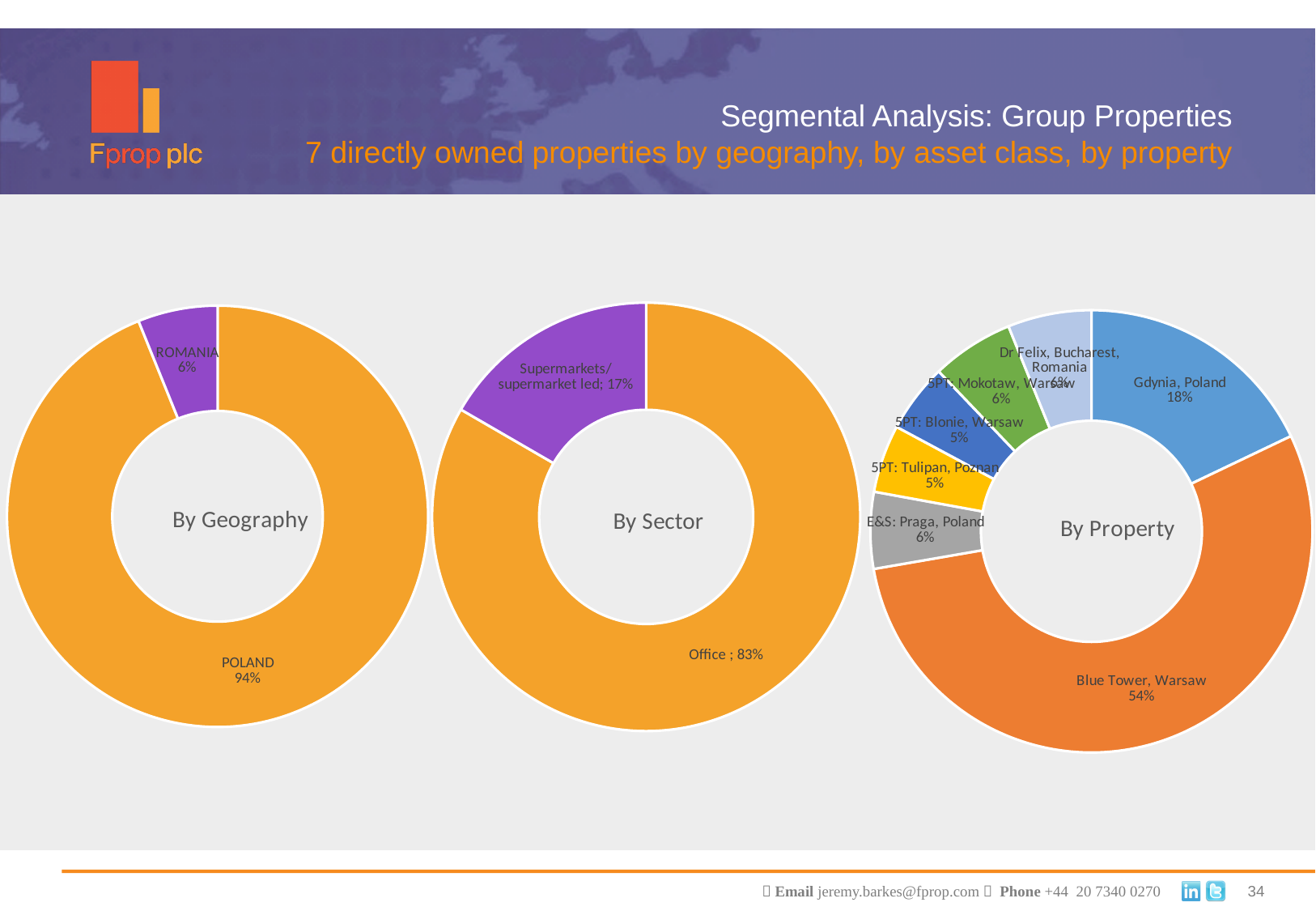
In the 'By Geography' chart, what share does POLAND have? 94% In the 'By Property' chart, what share does Blue Tower, Warsaw have? 54% In the 'By Sector' chart, which is larger, Office or Supermarkets/supermarket led? Office In the 'By Property' chart, which property has the largest share? Blue Tower, Warsaw How many charts are shown on the slide? 3 In the 'By Sector' chart, what share does Office have? 83% In the 'By Property' chart, how many properties are shown? 7 In the 'By Geography' chart, what share does ROMANIA have? 6% In the 'By Sector' chart, what share does Supermarkets/supermarket led have? 17% In the 'By Property' chart, what is the difference in share between Blue Tower, Warsaw and Gdynia, Poland? 36 percentage points In the 'By Property' chart, what share does Gdynia, Poland have? 18% What kind of chart is the 'By Geography' chart? Pie (donut) chart